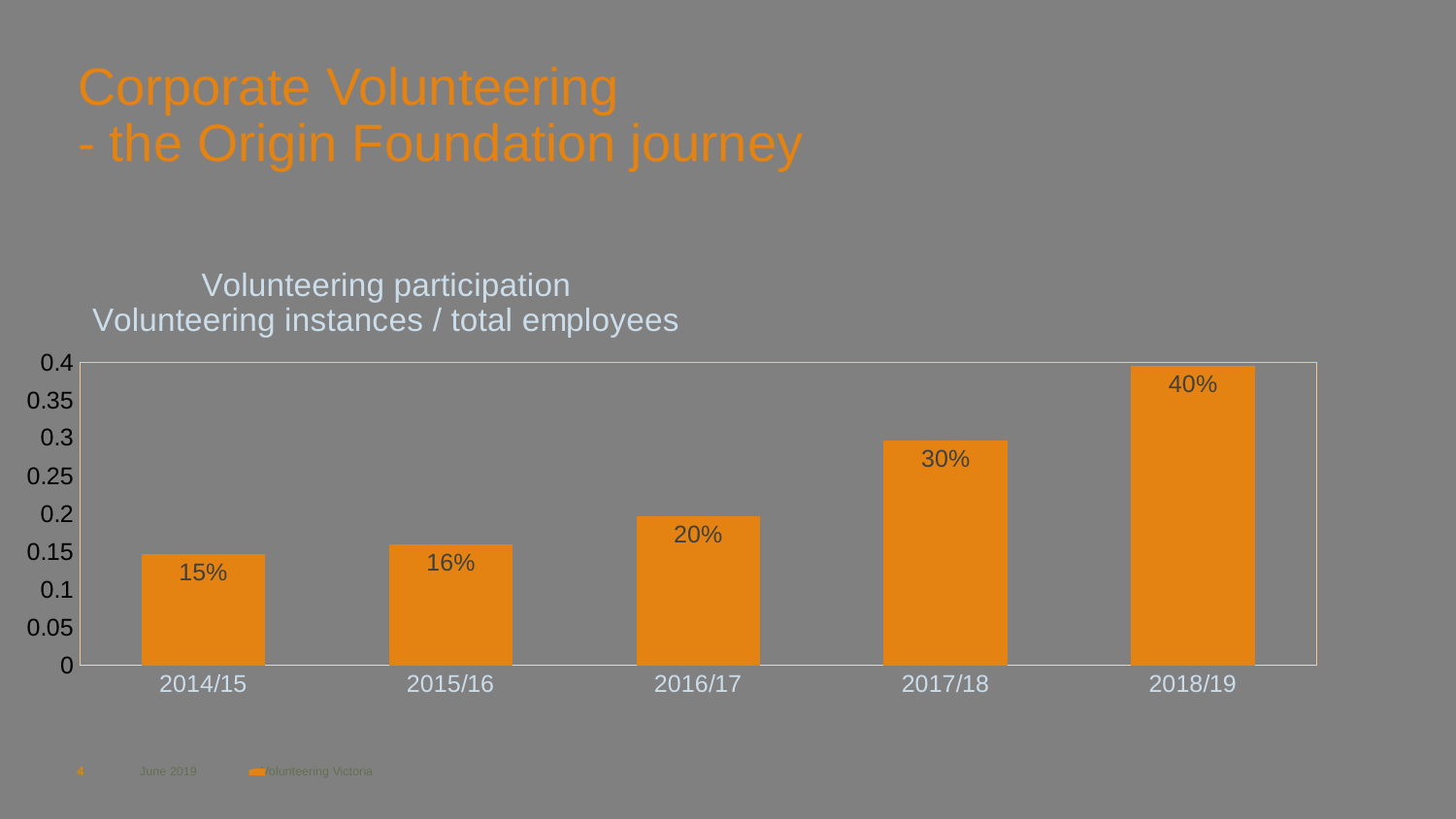
What is the difference in volunteering participation between 2018/19 and 2017/18? 10% How many years are shown on the chart? 5 Do the volunteering participation values rise or fall from 2014/15 to 2018/19? Rise What is the volunteering participation value for 2014/15? 15% What is the difference in volunteering participation between 2016/17 and 2015/16? 4% Which year has the highest volunteering participation? 2018/19 Is the value for 2017/18 greater or less than 0.25 on the axis? greater Which year has the lowest volunteering participation? 2014/15 What is the volunteering participation value for 2018/19? 40% Which year has a larger volunteering participation value, 2015/16 or 2017/18? 2017/18 What is the volunteering participation value for 2016/17? 20% What kind of chart is shown on the slide? Bar chart